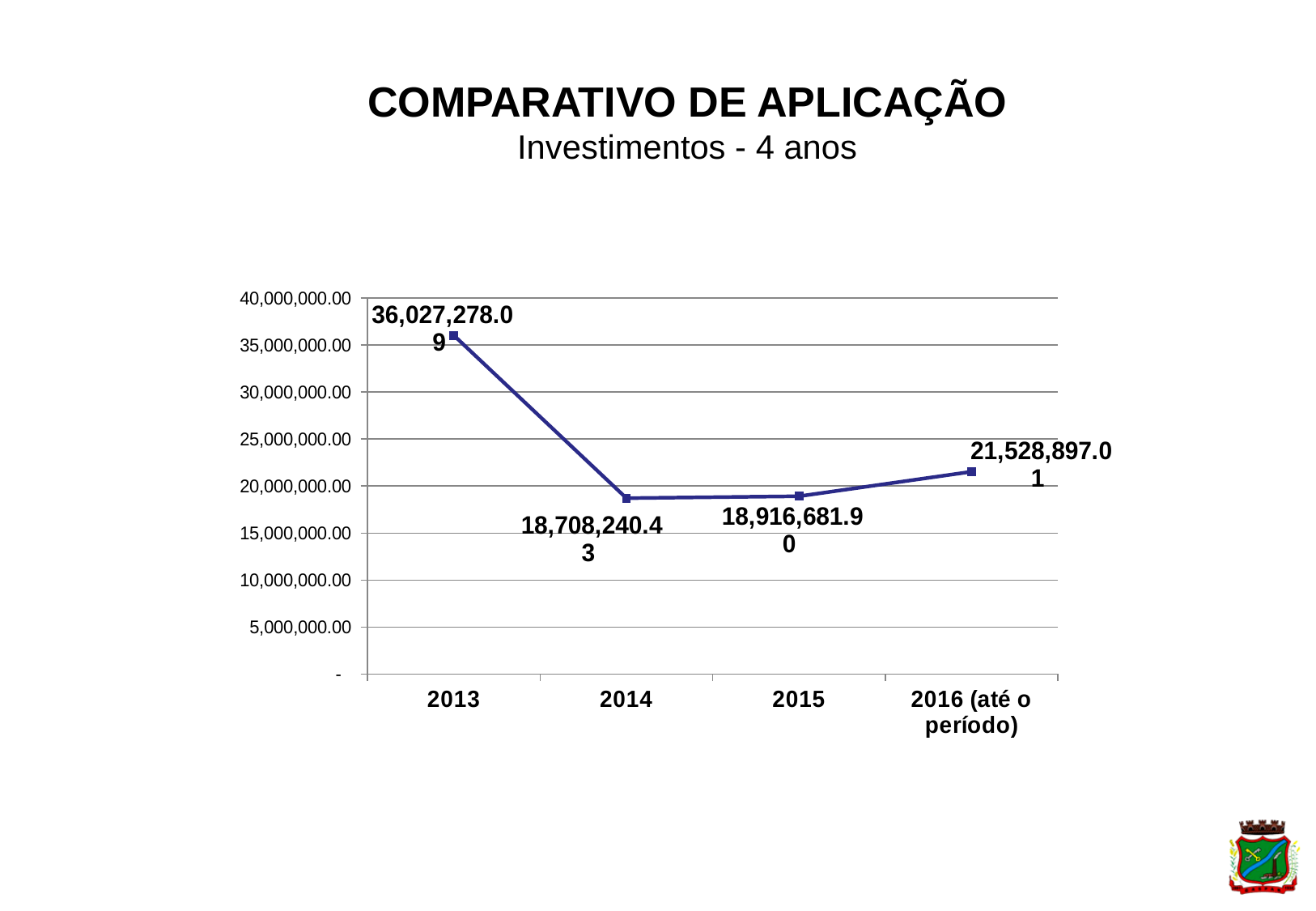
What is the value for 2014? 18,708,240.43 Which year has the highest value? 2013 What is the difference between the values for 2013 and 2014? 17,319,037.66 What is the value for 2013? 36,027,278.09 Which is larger, the value for 2014 or the value for 2015? 2015 What is the difference between the values for 2016 (até o período) and 2015? 2,612,215.11 What is the value for 2015? 18,916,681.90 Is the value for 2016 (até o período) greater or less than 20,000,000.00? greater Which year has the lowest value? 2014 What kind of chart is shown on the slide? line chart How many data points are plotted on the chart? 4 What is the value for 2016 (até o período)? 21,528,897.01